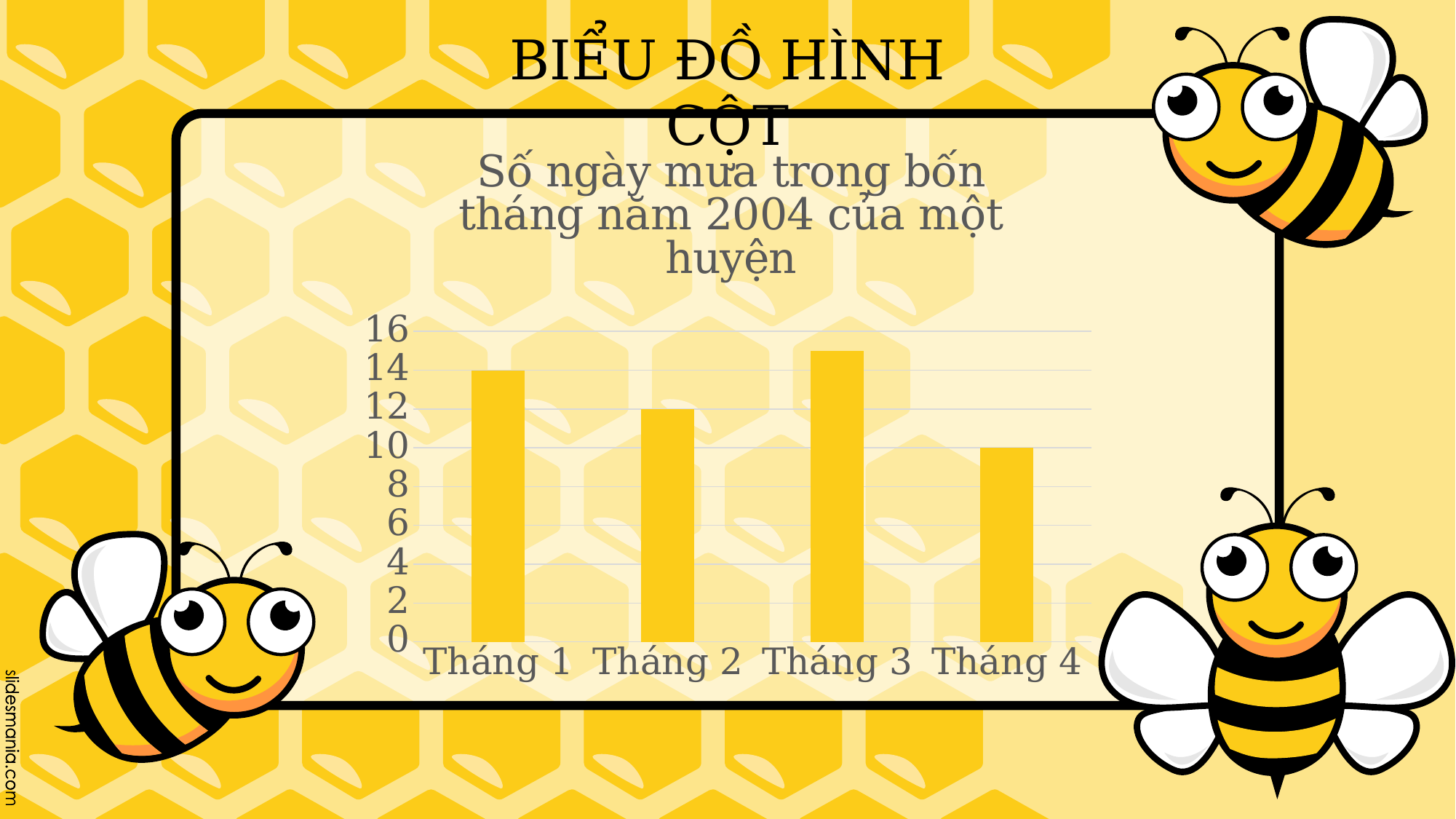
What is the title of the chart on the slide? Số ngày mưa trong bốn tháng năm 2004 của một huyện Is the value for Tháng 3 greater or less than 14? greater What type of chart is shown on the slide? Bar chart What is the value for Tháng 1 in the chart? 14 How many months (categories) are shown on the x axis of the chart? 4 Which is larger, the value for Tháng 1 or the value for Tháng 2? Tháng 1 What is the value for Tháng 4 in the chart? 10 Is the value for Tháng 3 greater or less than 16? less What is the value for Tháng 2 in the chart? 12 What is the difference between the values for Tháng 1 and Tháng 4? 4 Which month has the highest bar in the chart? Tháng 3 Which month has the lowest bar in the chart? Tháng 4